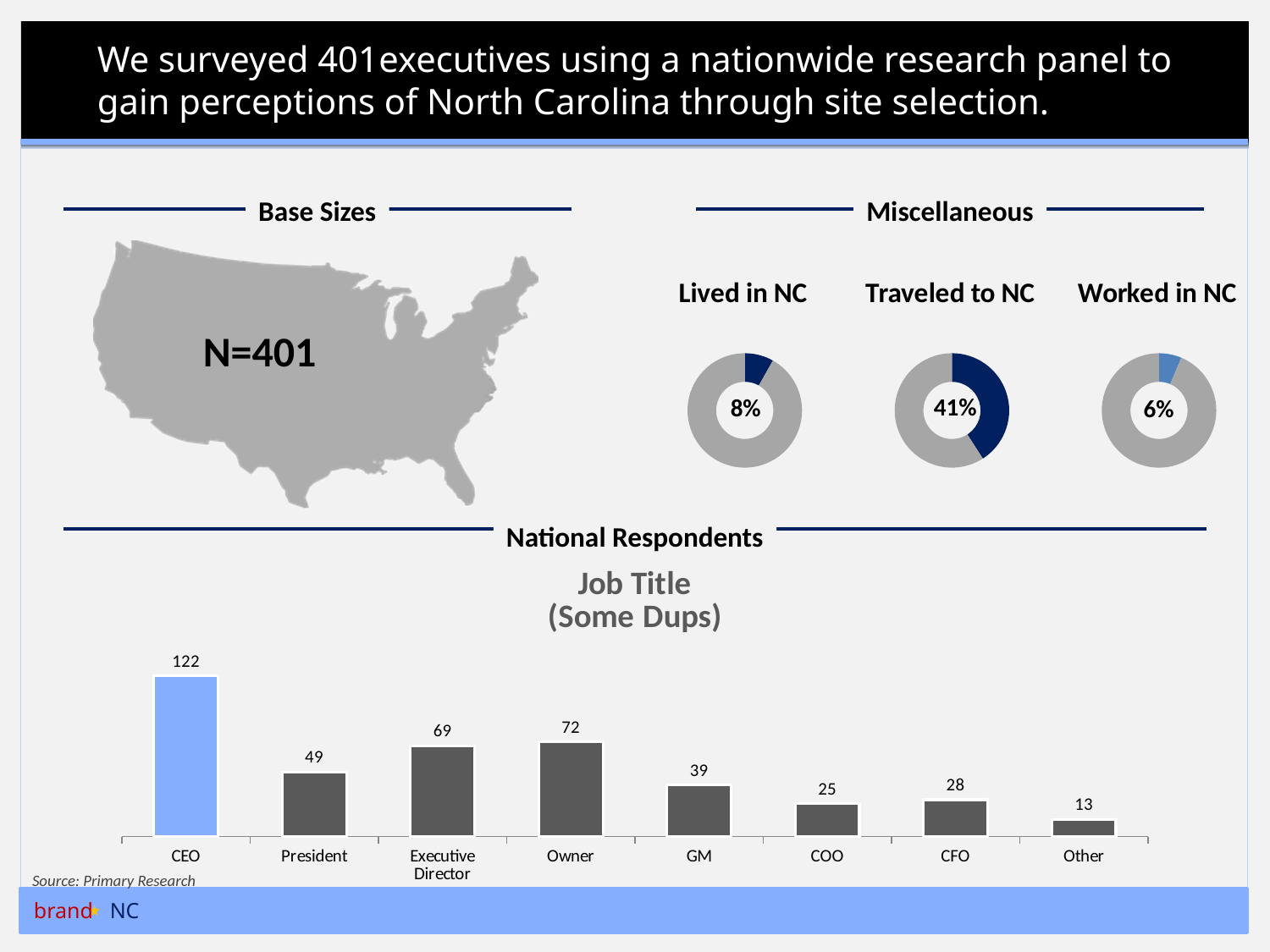
How many job title categories are shown in the Job Title bar chart? 8 In the Job Title bar chart, which bar is coloured light blue rather than dark grey? CEO In the Job Title bar chart, which job title has the highest value? CEO In the Job Title bar chart, what is the value for CEO? 122 In the Traveled to NC donut chart, what percentage is shown? 41% In the Job Title bar chart, which job title has the lowest value? Other In the Job Title bar chart, what is the difference between the values for CEO and Owner? 50 Among the three donut charts under Miscellaneous, which has the highest percentage? Traveled to NC In the Lived in NC donut chart, what percentage is shown? 8% In the Job Title bar chart, what is the value for Executive Director? 69 What kind of chart is the Job Title chart? Bar chart In the Job Title bar chart, which is larger, the value for President or the value for GM? President